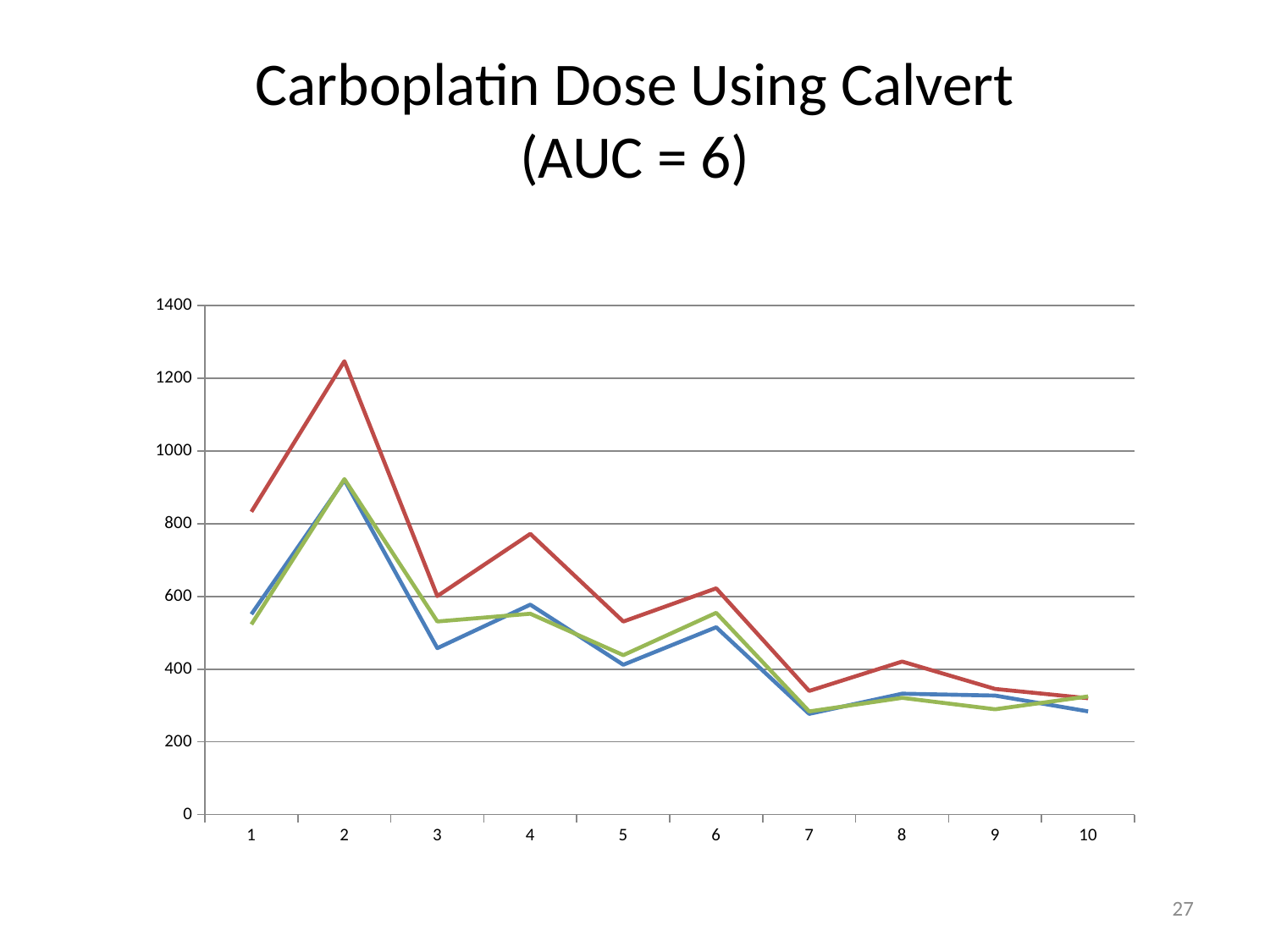
Is the value of the blue line at category 10 greater or less than 400? less What kind of chart is shown on the slide? line chart How many lines are plotted on the chart? 3 How many points are plotted along the x axis? 10 What is the title of the chart slide? Carboplatin Dose Using Calvert (AUC = 6) At which x-axis category does the red line reach its highest value? 2 Is the value of the red line at category 7 greater or less than 400? less Is the value of the blue line at category 3 greater or less than 600? less At category 2, which line has the larger value, the red line or the blue line? red line Does the red line rise or fall from category 2 to category 3? fall